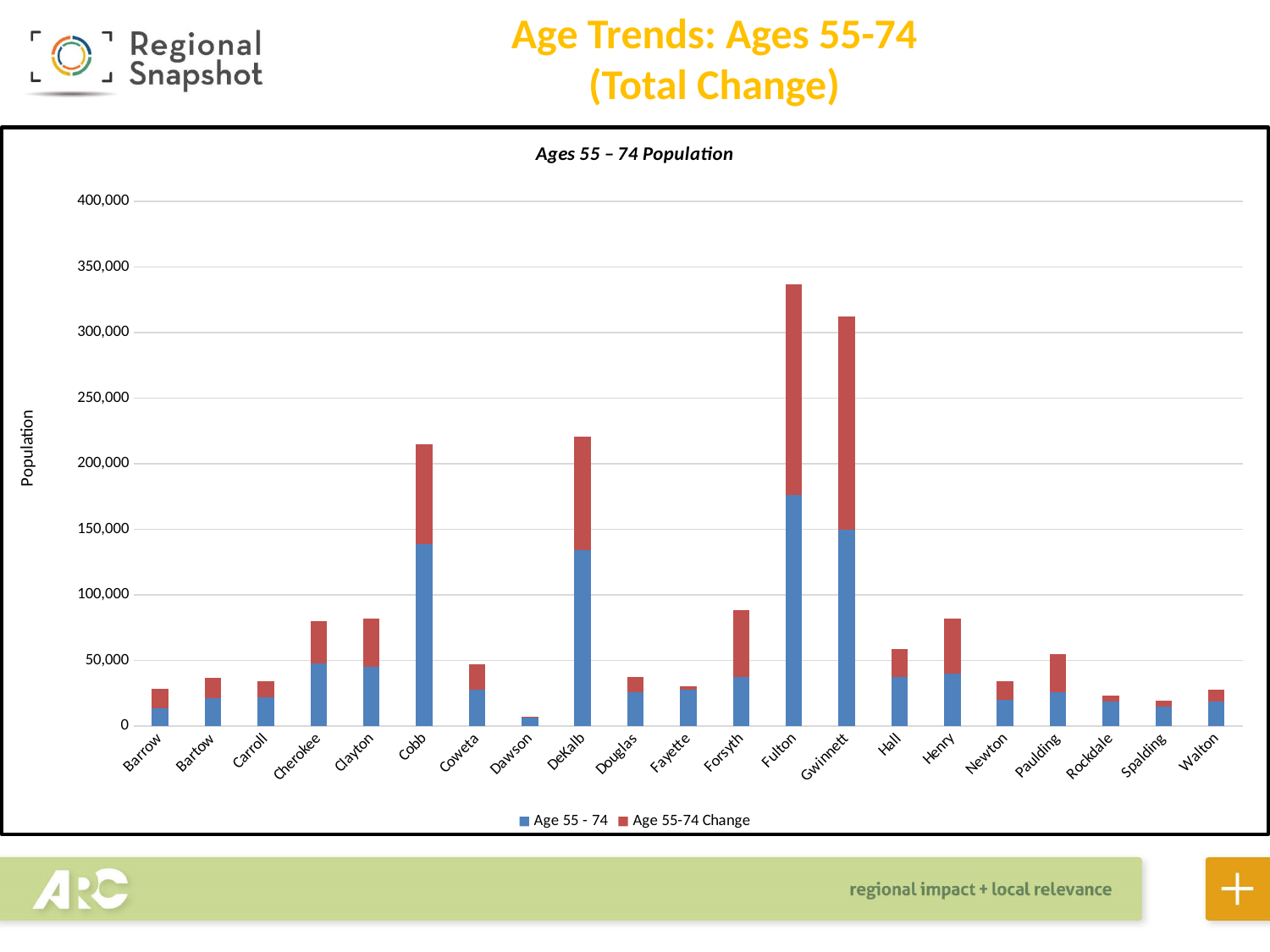
What are the two series named in the chart's legend? Age 55 - 74 and Age 55-74 Change Which county has the shortest total bar in the chart? Dawson Is the total bar for Fulton greater or less than 300,000? greater Is the total bar for Cherokee greater or less than 50,000? greater How many counties are shown along the x axis of the chart? 21 Which county has a taller total bar, Cobb or DeKalb? DeKalb Which county has the tallest total bar in the chart? Fulton What kind of chart is shown on the slide? Stacked bar chart Is the total bar for Cobb greater or less than 250,000? less Which county has a taller total bar, Fulton or Gwinnett? Fulton What is the title of the chart? Ages 55 – 74 Population How many series does the chart's legend list? 2